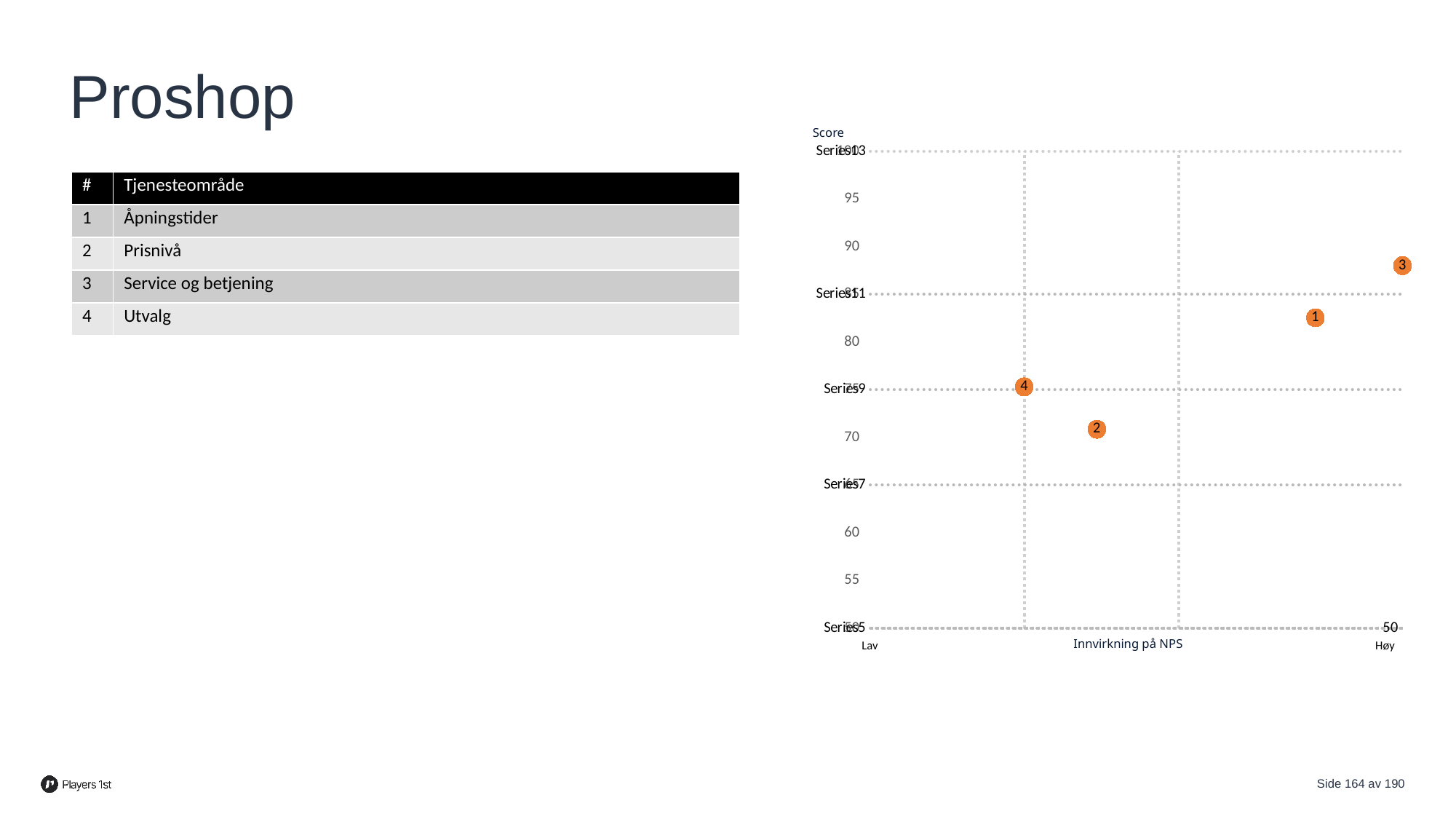
Which service area (from the table) corresponds to the point with the highest score? Service og betjening Is the score for point 3 greater or less than 85? greater Which numbered point has the highest score on the chart? 3 Is the score for point 2 greater or less than 75? less How many data points are plotted on the chart? 4 What kind of chart is shown on the slide? scatter chart Which has a higher score on the chart, point 1 or point 4? point 1 What is the title of the horizontal axis of the chart? Innvirkning på NPS Is the score for point 1 greater or less than 80? greater What is the title of the vertical axis of the chart? Score Which numbered point has the lowest score on the chart? 2